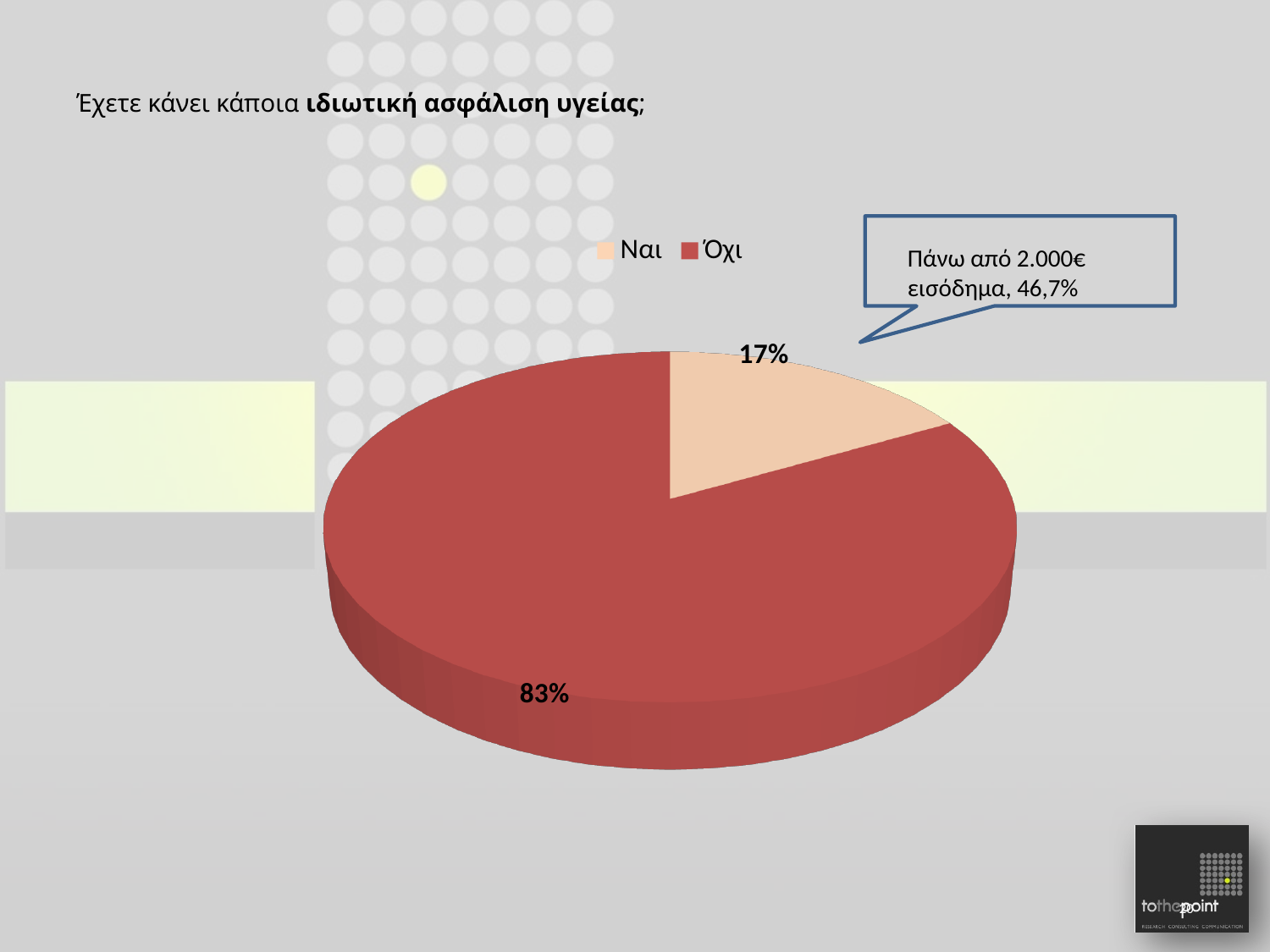
What is the difference in percentage points between Όχι and Ναι? 66 What kind of chart is shown on the slide? Pie chart How many categories does the pie chart show? 2 Which category has the largest share of the pie? Όχι What percentage is given in the callout box for respondents with income above 2.000€? 46,7% What percentage of respondents answered Ναι (Yes)? 17% What colour is the Όχι slice in the pie chart? Red What share of the pie does the Ναι slice represent? 17% What percentage of respondents answered Όχι (No)? 83% Which is larger, the share for Ναι or the share for Όχι? Όχι Which category has the smallest share of the pie? Ναι How many entries does the legend list? 2